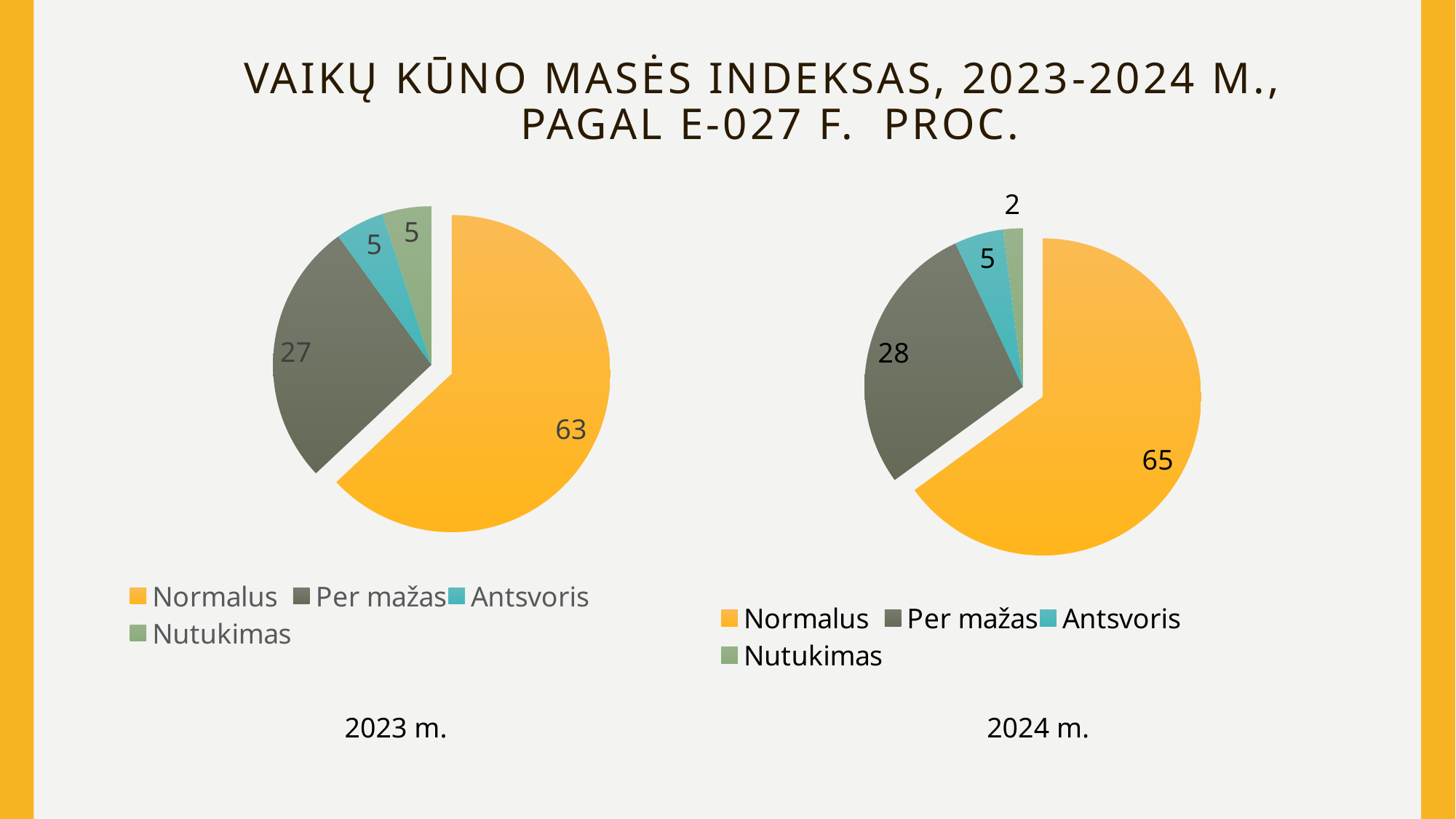
In the 2024 m. pie chart, what is the value for Nutukimas? 2 What type of chart is used for the 2024 m. data? Pie chart In the 2024 m. pie chart, what is the value for Per mažas? 28 How many categories does the 2023 m. pie chart have? 4 What is the difference between the Normalus value in the 2024 m. chart and the Normalus value in the 2023 m. chart? 2 Which is larger: Per mažas in the 2023 m. chart or Per mažas in the 2024 m. chart? 2024 m. In the 2023 m. pie chart, what is the value for Antsvoris? 5 In the 2024 m. pie chart, what is the difference between the Normalus and Per mažas values? 37 In the 2023 m. pie chart, what is the value for Normalus? 63 In the 2023 m. pie chart, which category has the largest slice? Normalus In the 2024 m. pie chart, which category has the smallest slice? Nutukimas How many entries does the legend of the 2024 m. chart list? 4